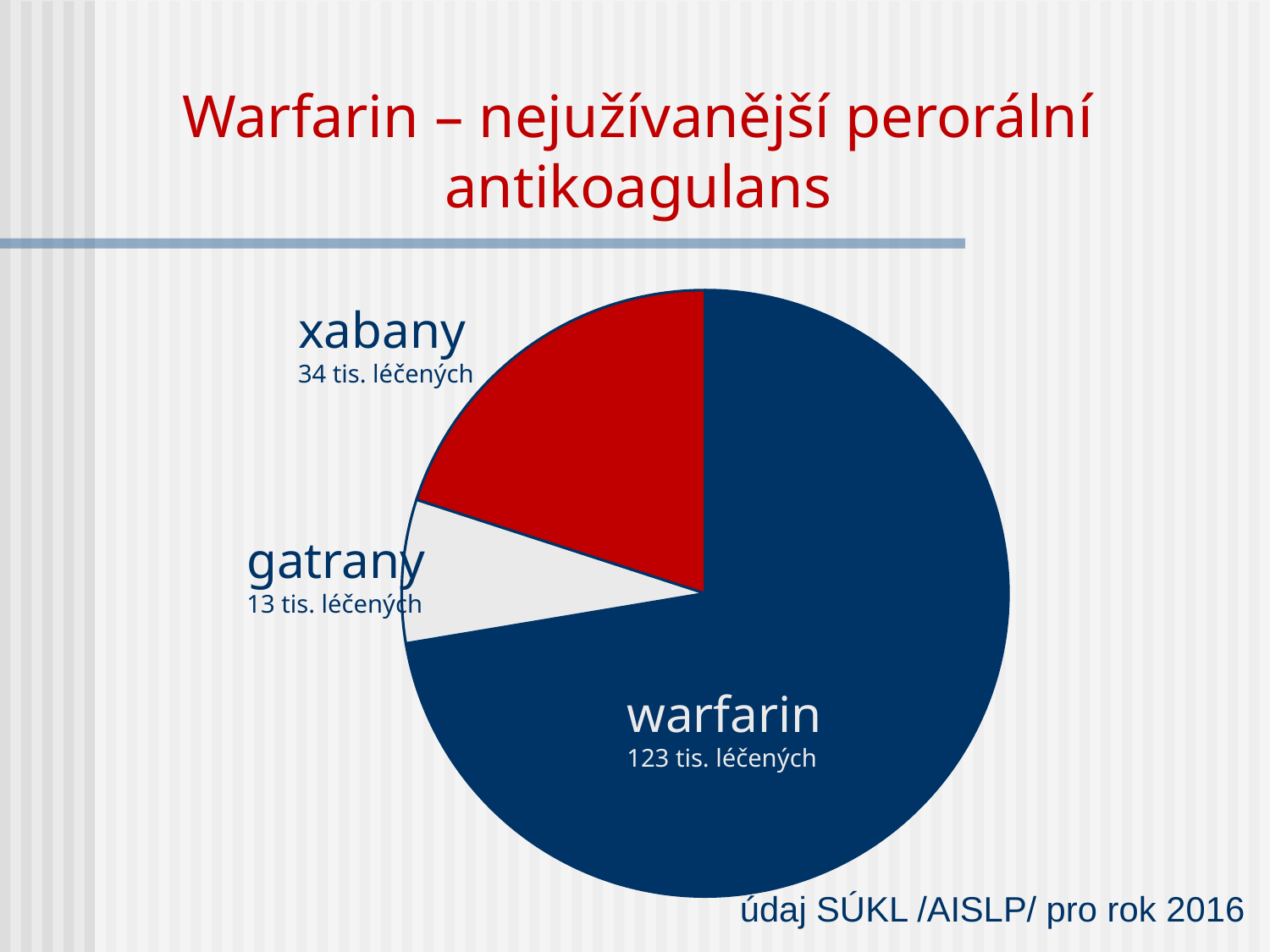
What is the difference in thousands of treated patients between warfarin and xabany? 89 tis. How many treated patients does the pie chart show for gatrany? 13 tis. léčených How many slices does the pie chart have? 3 How many treated patients does the pie chart show for warfarin? 123 tis. léčených What colour is the warfarin slice of the pie chart? dark blue What is the total number of treated patients across all three slices of the pie chart? 170 tis. Which category has the smallest slice of the pie chart? gatrany What is the difference in thousands of treated patients between xabany and gatrany? 21 tis. What type of chart is shown on the slide? pie chart Which category has the largest slice of the pie chart? warfarin How many treated patients does the pie chart show for xabany? 34 tis. léčených Which has more treated patients, xabany or gatrany? xabany